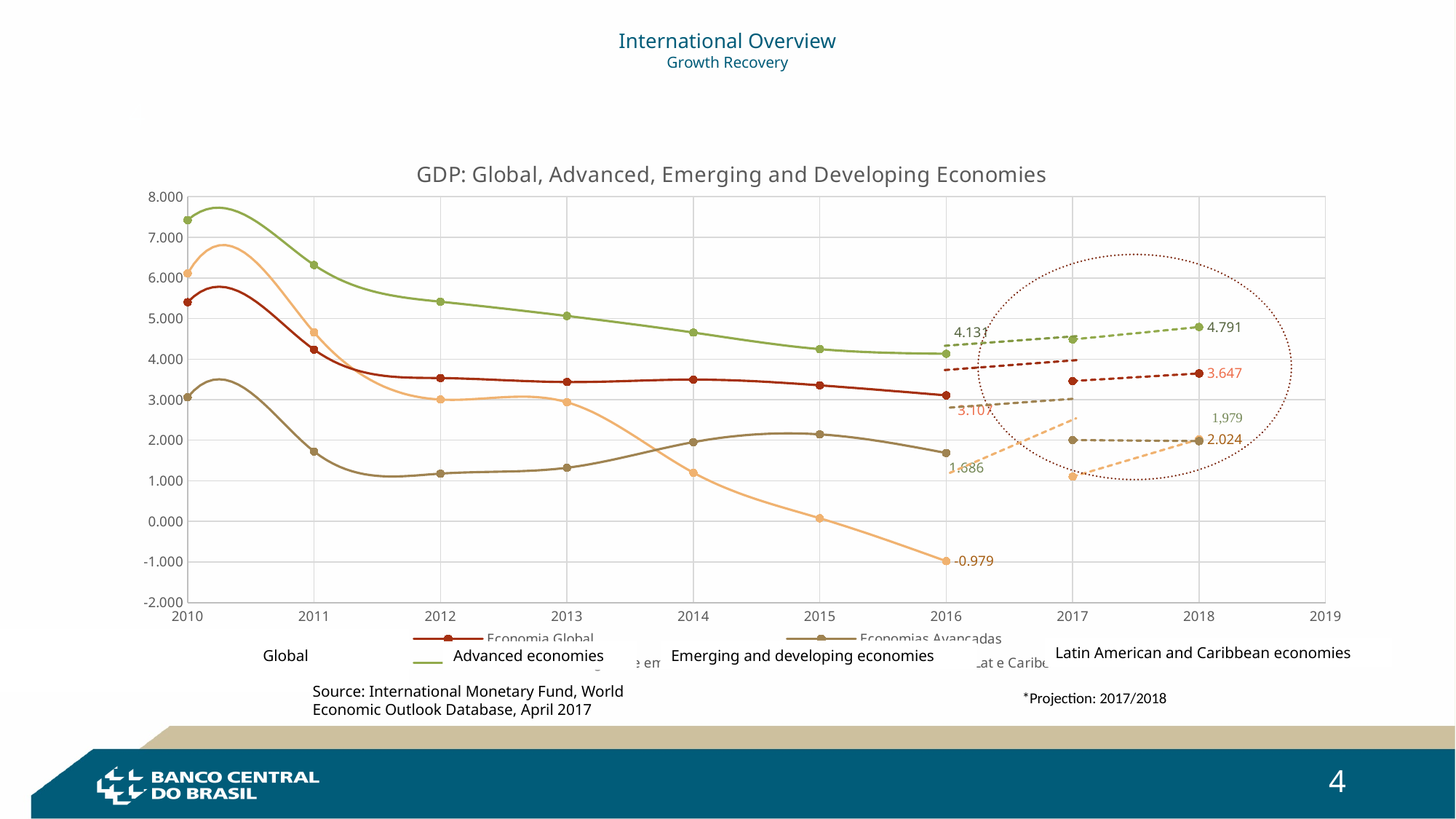
What value is labelled on the red line for 2016? 3.107 Does the orange line rise or fall between 2013 and 2016? fall What value is labelled on the green line for 2018? 4.791 What is the title of the chart? GDP: Global, Advanced, Emerging and Developing Economies Is the value of the orange line in 2015 greater or less than 1.000? less By how much does the green line's labelled value rise from 2016 (4.131) to 2018 (4.791)? 0.660 In 2018, which labelled value is larger: the green line's or the red line's? the green line's (4.791) What kind of chart is shown on the slide? line chart Which line has the lowest value in 2016? the orange line (-0.979) What value is labelled on the red line for 2018? 3.647 What value is labelled on the orange line for 2016? -0.979